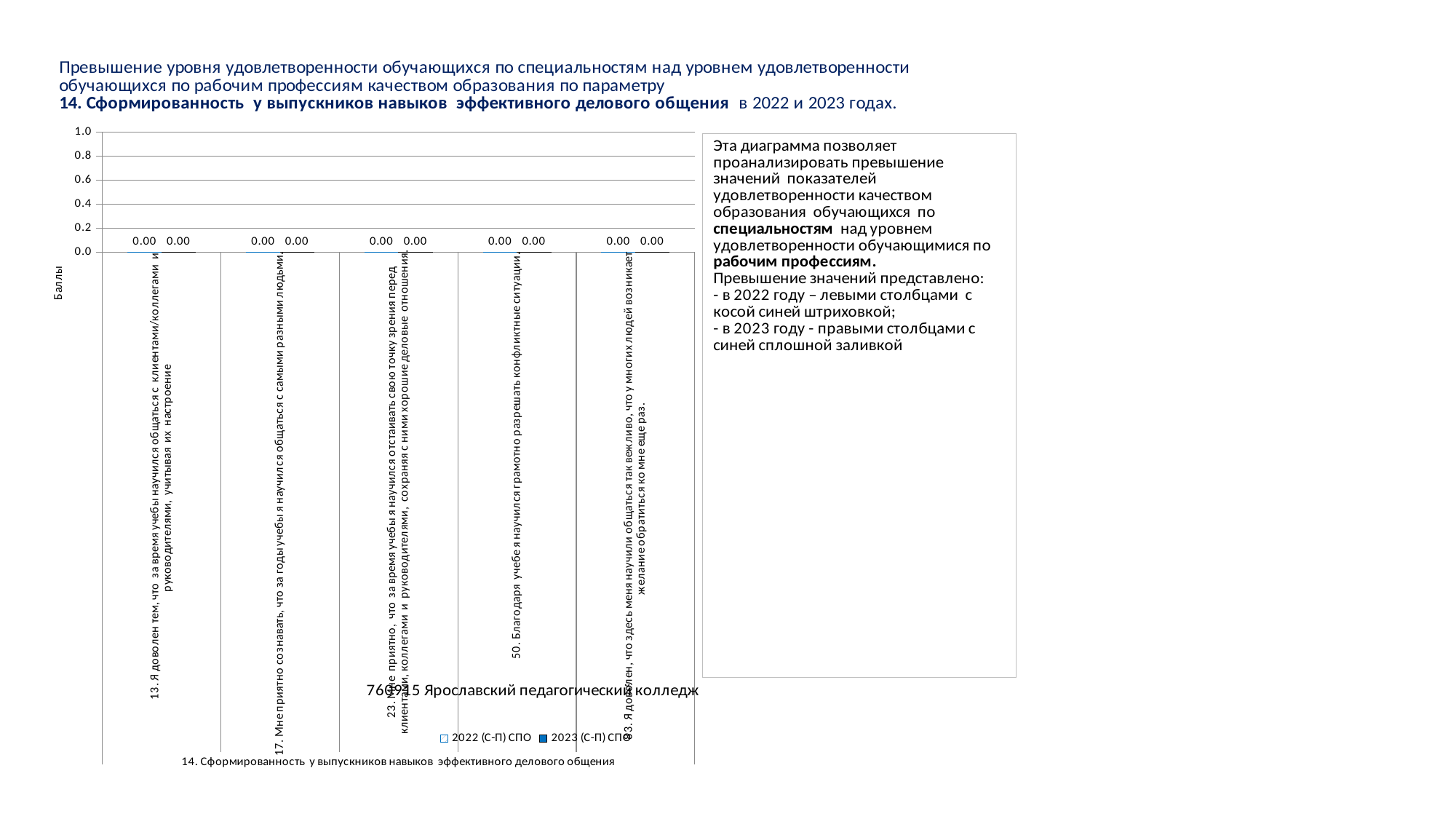
What are the two series names shown in the chart legend? 2022 (С-П) СПО and 2023 (С-П) СПО How many categories (statements) are plotted on the x axis of the chart? 5 What is the maximum value shown on the y axis of the chart? 1.0 Is the value of the 2023 (С-П) СПО series for statement 13 greater or less than 0.2? less What is the difference between the 2022 (С-П) СПО and 2023 (С-П) СПО values for statement 23? 0.00 What is the label of the vertical (y) axis of the chart? Баллы What type of chart is shown on the slide? bar chart How many series does the chart legend list? 2 What is the value of the 2023 (С-П) СПО series for statement 17 ("Мне приятно сознавать, что за годы учебы я научился общаться с самыми разными людьми")? 0.00 What is the value of the 2022 (С-П) СПО series for statement 13 ("Я доволен тем, что за время учебы научился общаться с клиентами/коллегами и руководителями...")? 0.00 What is the value of the 2023 (С-П) СПО series for statement 50 ("Благодаря учебе я научился грамотно разрешать конфликтные ситуации")? 0.00